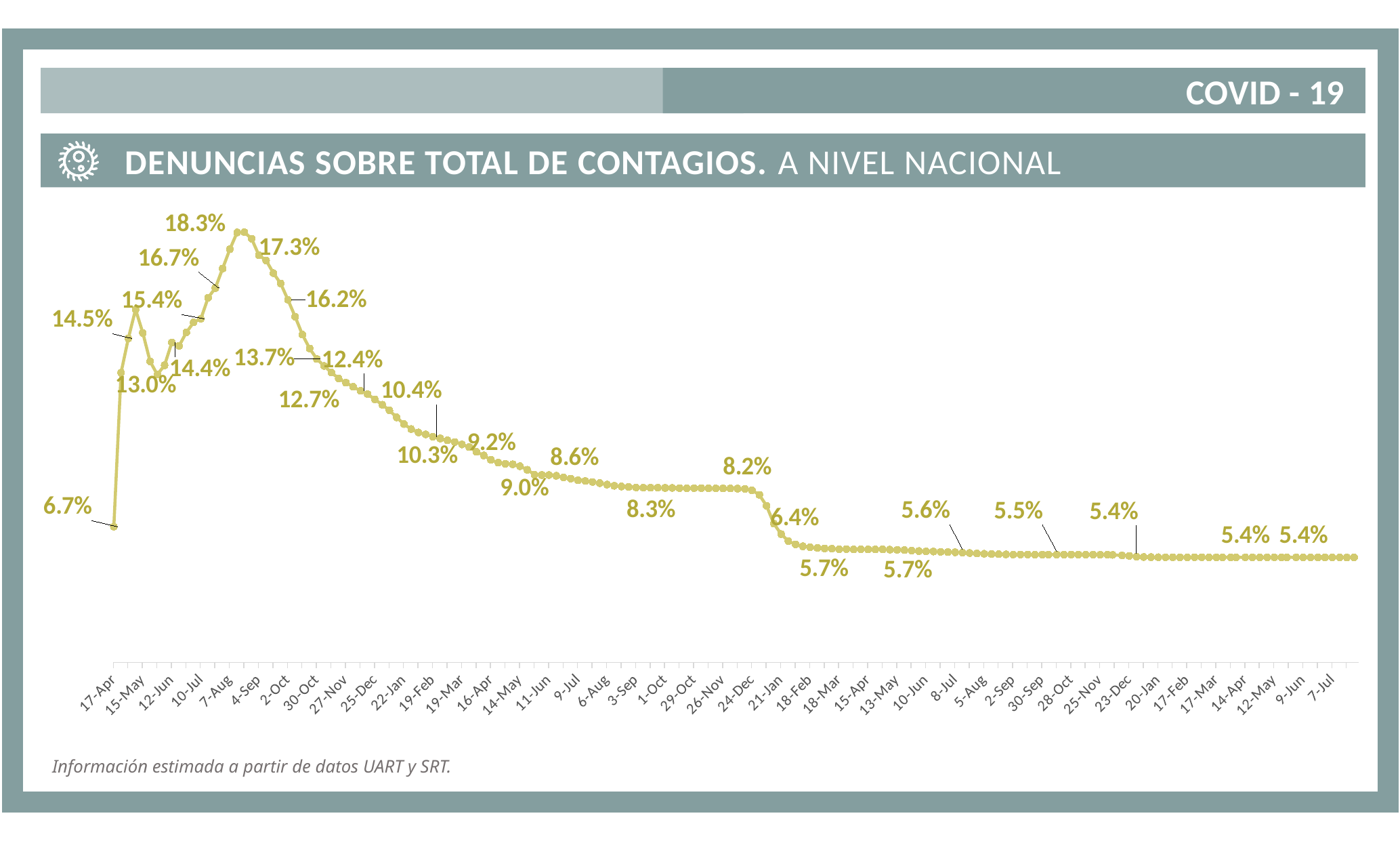
Which is larger, the labelled value 14.5% near the start or the labelled value 15.4% just after it? 15.4% What is the highest value labelled on the chart? 18.3% What is the difference between the peak value of 18.3% and the starting value of 6.7%? 11.6 percentage points After reaching its peak of 18.3%, do the values generally rise or fall along the x axis? fall What is the value of the last data point on the right of the chart? 5.4% What kind of chart is shown on the slide? line chart How many data series are plotted on the chart? 1 Which is larger, the value labelled 8.2% or the value labelled 6.4% that follows it? 8.2% What is the difference between the peak value of 18.3% and the final value of 5.4%? 12.9 percentage points What is the title of the chart? DENUNCIAS SOBRE TOTAL DE CONTAGIOS. A NIVEL NACIONAL What is the lowest value labelled on the chart? 5.4% What is the value of the first data point, at 17-Apr? 6.7%